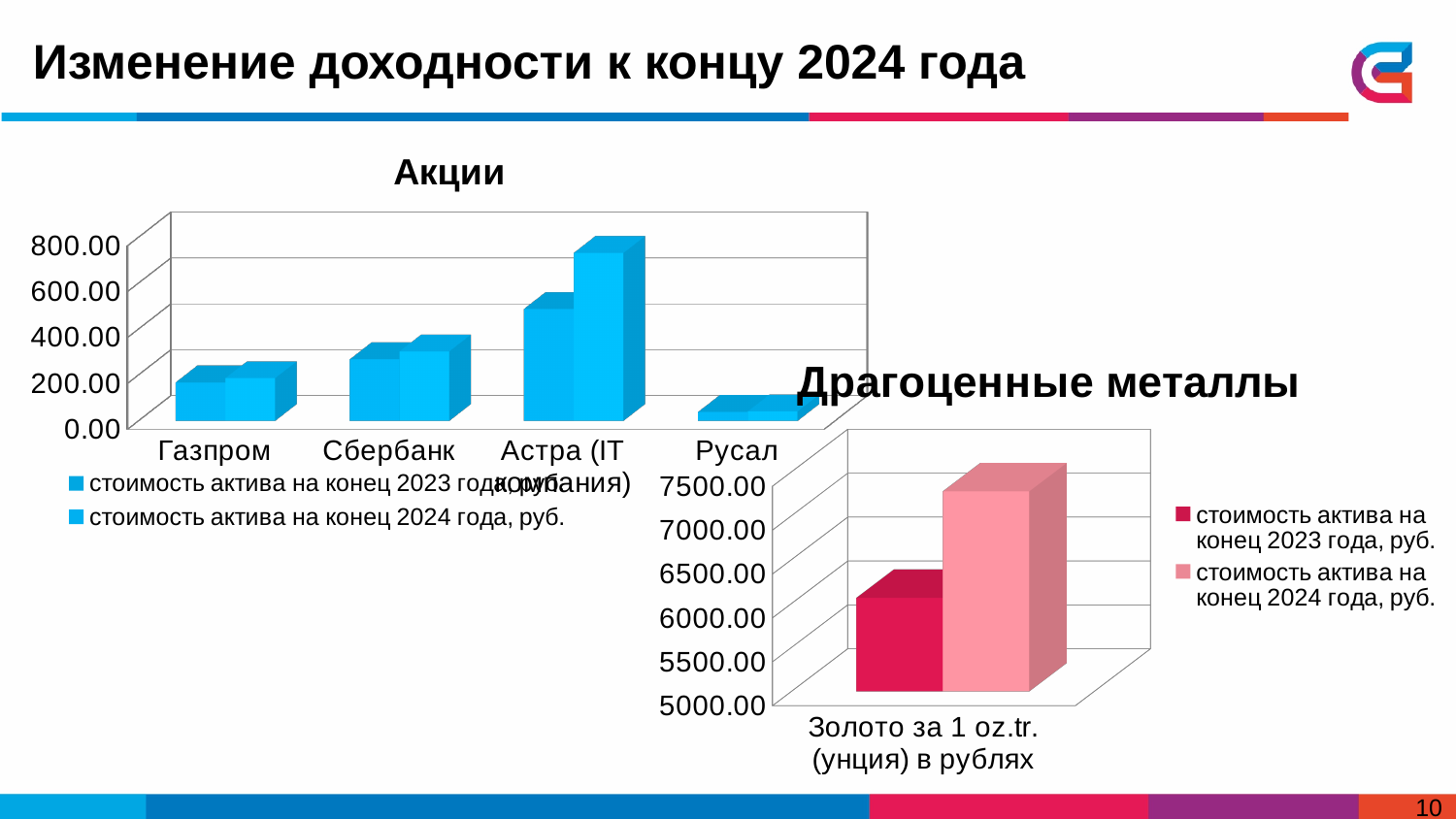
In the "Акции" chart, is the value for Сбербанк at the end of 2023 greater or less than 400? less What kind of chart is the "Акции" chart? bar chart In the "Акции" chart, is the value for Астра (IT компания) at the end of 2024 greater or less than 600? greater In the "Акции" chart, which company has the lowest value for стоимость актива на конец 2024 года? Русал How many companies are shown on the x axis of the "Акции" chart? 4 How many categories are shown on the x axis of the "Драгоценные металлы" chart? 1 In the "Акции" chart, which is larger for the end of 2024: Сбербанк or Астра (IT компания)? Астра (IT компания) In the "Акции" chart, which company has the highest value for стоимость актива на конец 2024 года? Астра (IT компания) In the "Драгоценные металлы" chart, which is larger for gold: the value at the end of 2023 or at the end of 2024? end of 2024 How many series does the legend of the "Акции" chart list? 2 In the "Драгоценные металлы" chart, is the value of gold at the end of 2024 greater or less than 7000? greater What is the category label on the x axis of the "Драгоценные металлы" chart? Золото за 1 oz.tr. (унция) в рублях